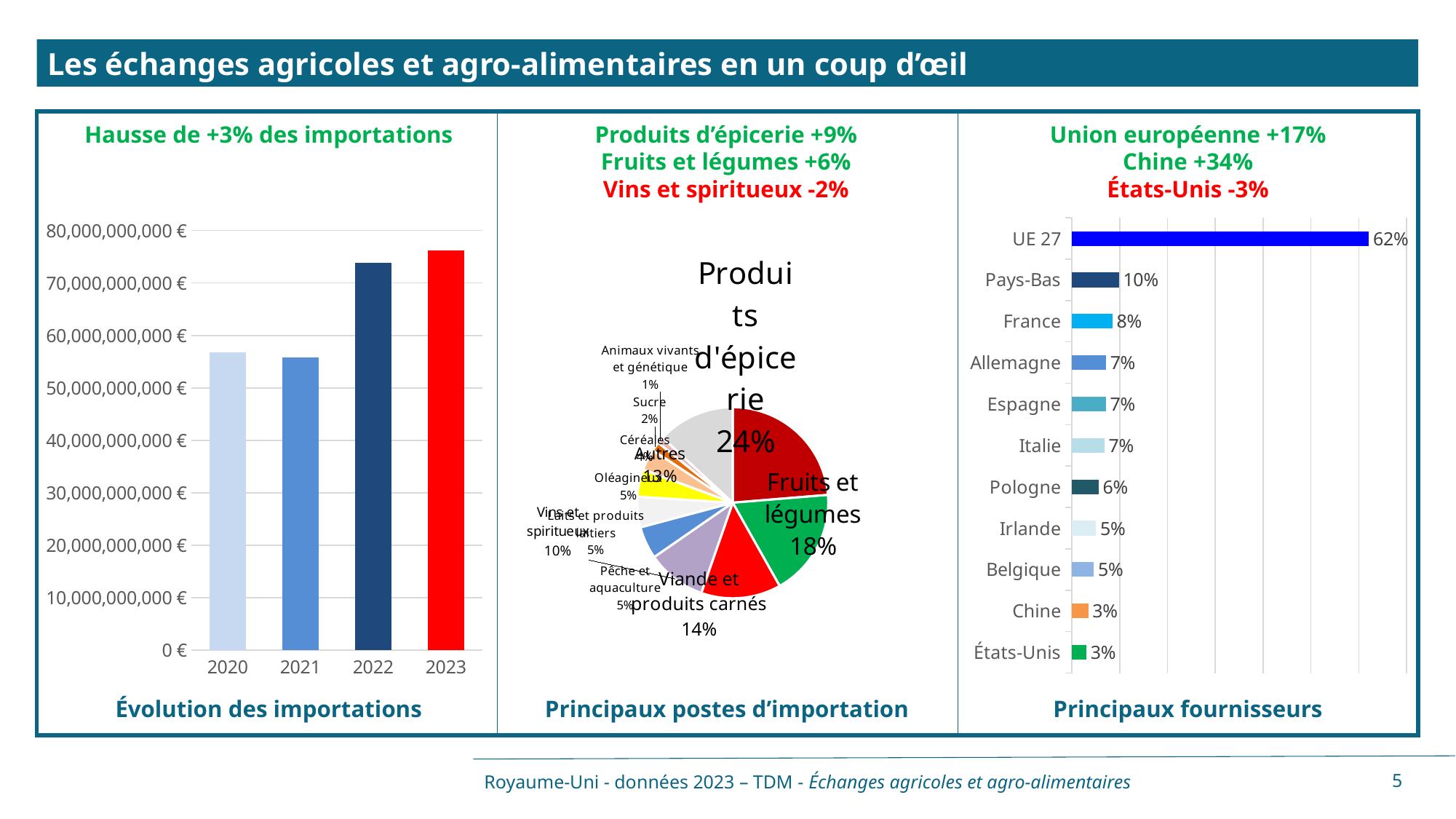
In the 'Principaux postes d'importation' pie chart, which category has the largest slice? Produits d'épicerie In the 'Principaux fournisseurs' chart, how many suppliers are listed? 11 In the 'Principaux postes d'importation' pie chart, what share does 'Produits d'épicerie' have? 24% In the 'Évolution des importations' chart, how many years are shown on the x axis? 4 In the 'Principaux postes d'importation' pie chart, what is the share of 'Viande et produits carnés'? 14% In the 'Principaux fournisseurs' chart, what is the difference between UE 27 and France? 54% In the 'Évolution des importations' chart, which year has the highest value? 2023 In the 'Principaux fournisseurs' chart, which is larger, Pologne or Chine? Pologne In the 'Évolution des importations' chart, is the value for 2023 greater or less than 70,000,000,000 €? greater In the 'Principaux fournisseurs' chart, what is the value for Pays-Bas? 10% What kind of chart is 'Principaux postes d'importation'? pie chart In the 'Évolution des importations' chart, is the value for 2020 greater or less than 60,000,000,000 €? less